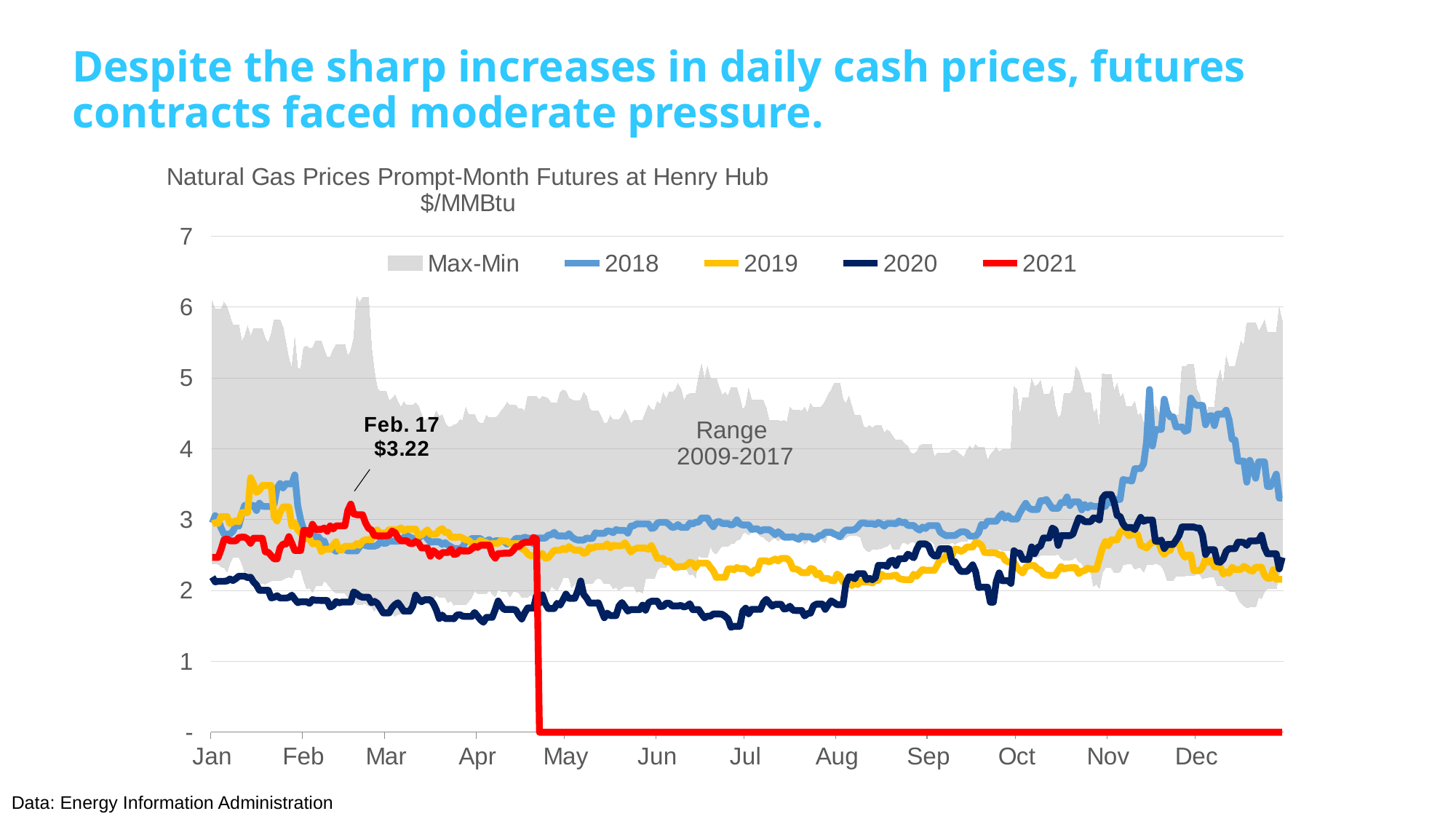
How many entries does the chart legend list? 5 Does the 2018 series rise or fall between September and mid-November? rise In July, which series is higher: 2018 or 2020? 2018 Is the value of the 2019 series in December greater or less than 3? less Is the value of the 2020 series in early July greater or less than 2? less Is the peak value of the 2018 series in mid-November greater or less than 4? greater How many month labels are shown on the x axis? 12 What kind of chart is shown on the slide? line chart What value is annotated for the 2021 series on Feb. 17? $3.22 Which years does the shaded Max-Min range cover, according to the label inside the chart? 2009-2017 What is the title of the chart? Natural Gas Prices Prompt-Month Futures at Henry Hub $/MMBtu